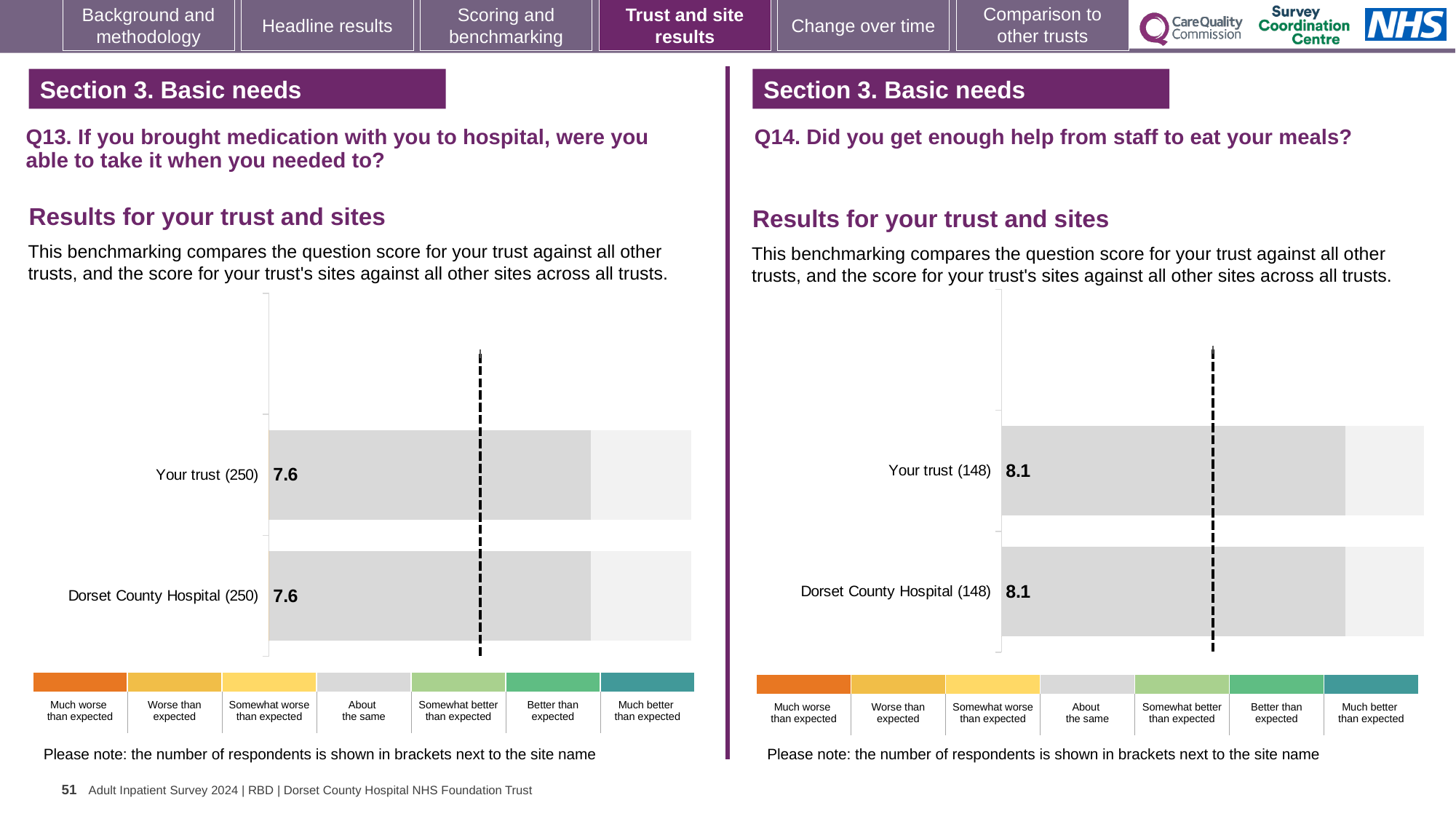
On the Q13 chart (left), what is the difference between the score for Your trust and the score for Dorset County Hospital? 0 On the Q14 chart (right), how many respondents are shown in brackets for Dorset County Hospital? 148 On the Q13 chart (left), what is the score for Dorset County Hospital? 7.6 On the Q14 chart (right), what is the score for Dorset County Hospital? 8.1 On the Q14 chart (right), what is the score for Your trust? 8.1 On the Q14 chart (right), what is the difference between the score for Your trust and the score for Dorset County Hospital? 0 On the Q14 chart (right), which benchmark category does the grey colour of the bars correspond to in the key? About the same How many bars are plotted on the Q13 chart (left)? 2 What kind of chart is the Q14 chart (right)? Bar chart On the Q13 chart (left), how many respondents are shown in brackets for Your trust? 250 On the Q13 chart (left), what is the score for Your trust? 7.6 How many categories does the colour key below the Q13 chart (left) list? 7